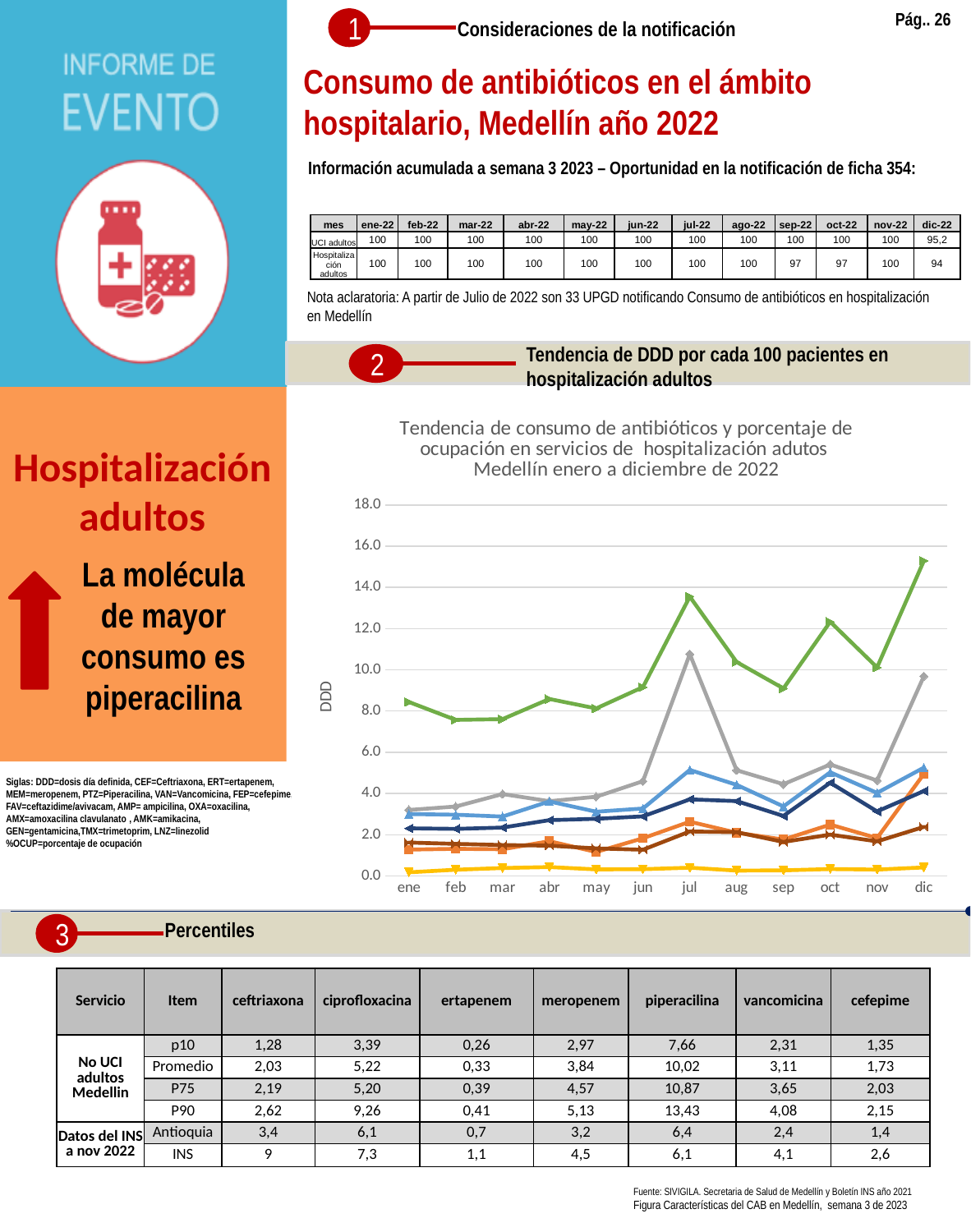
How many months are plotted along the x axis of the line chart? 12 In the line chart, is the value of the yellow line in dic greater or less than 2.0? less What is the label on the vertical axis of the line chart? DDD In the line chart, is the value of the gray line in jul greater or less than 10.0? greater In the line chart, is the value of the green line in dic greater or less than 14.0? greater In the line chart, in which month does the gray line reach its highest value? jul In the line chart, does the green line rise or fall overall from ene to dic? rise In the line chart, which line has the higher value in dic, the green line or the gray line? green line What kind of chart is shown under the title 'Tendencia de consumo de antibióticos y porcentaje de ocupación'? line chart What is the highest tick value shown on the vertical axis of the line chart? 18.0 In the line chart, in which month does the green line reach its highest value? dic